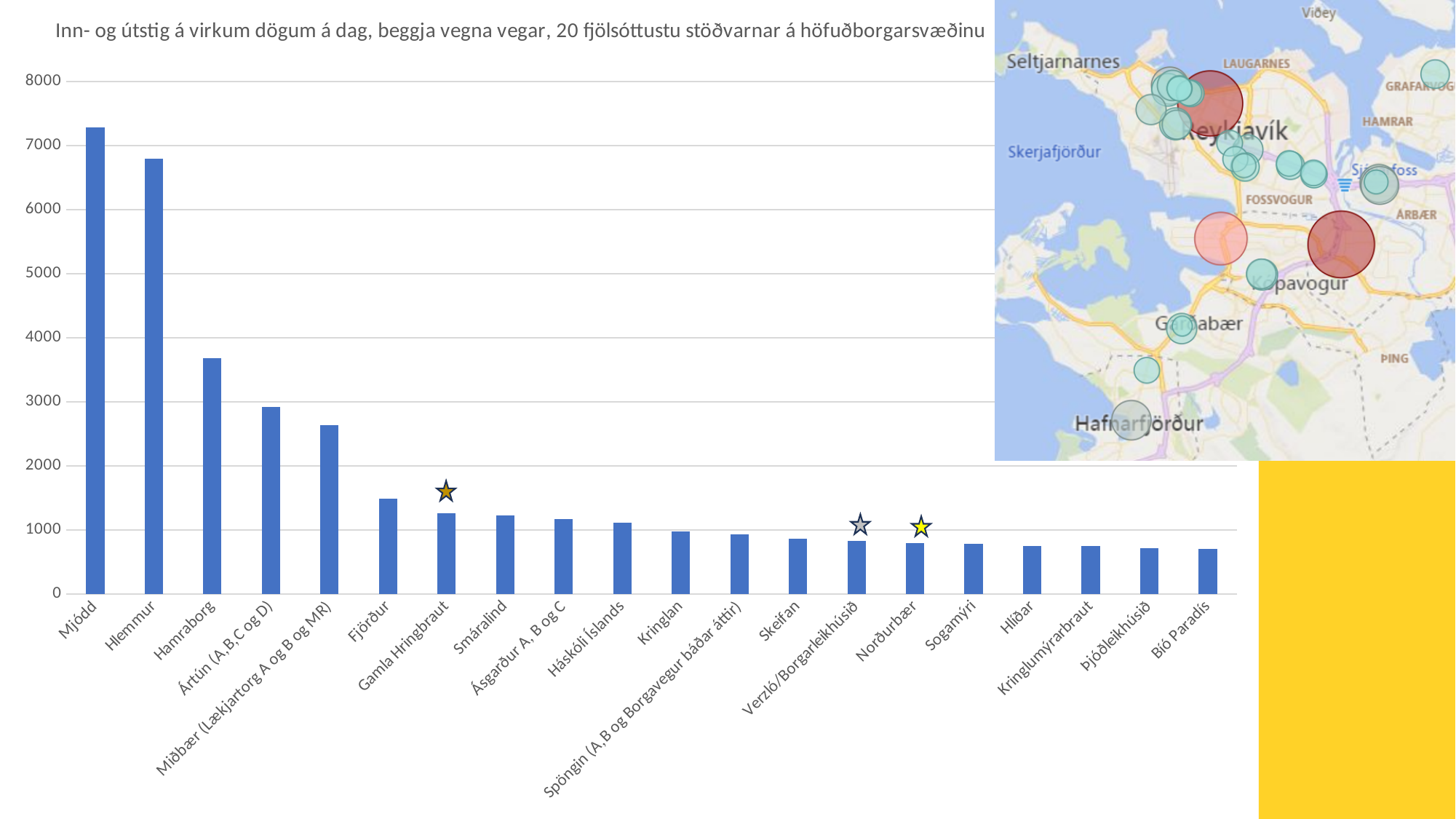
Is the value for Fjörður greater or less than 1000? greater Is the value for Hlemmur greater or less than 7000? less How many stations (categories) are plotted in the chart? 20 Which has a larger value, Hamraborg or Fjörður? Hamraborg Do the values rise or fall moving from left to right along the x axis? fall What kind of chart is shown on the slide? bar chart Which station has the highest value in the chart? Mjódd Is the value for Ártún (A, B, C og D) greater or less than 3000? less Which has a larger value, Mjódd or Hlemmur? Mjódd